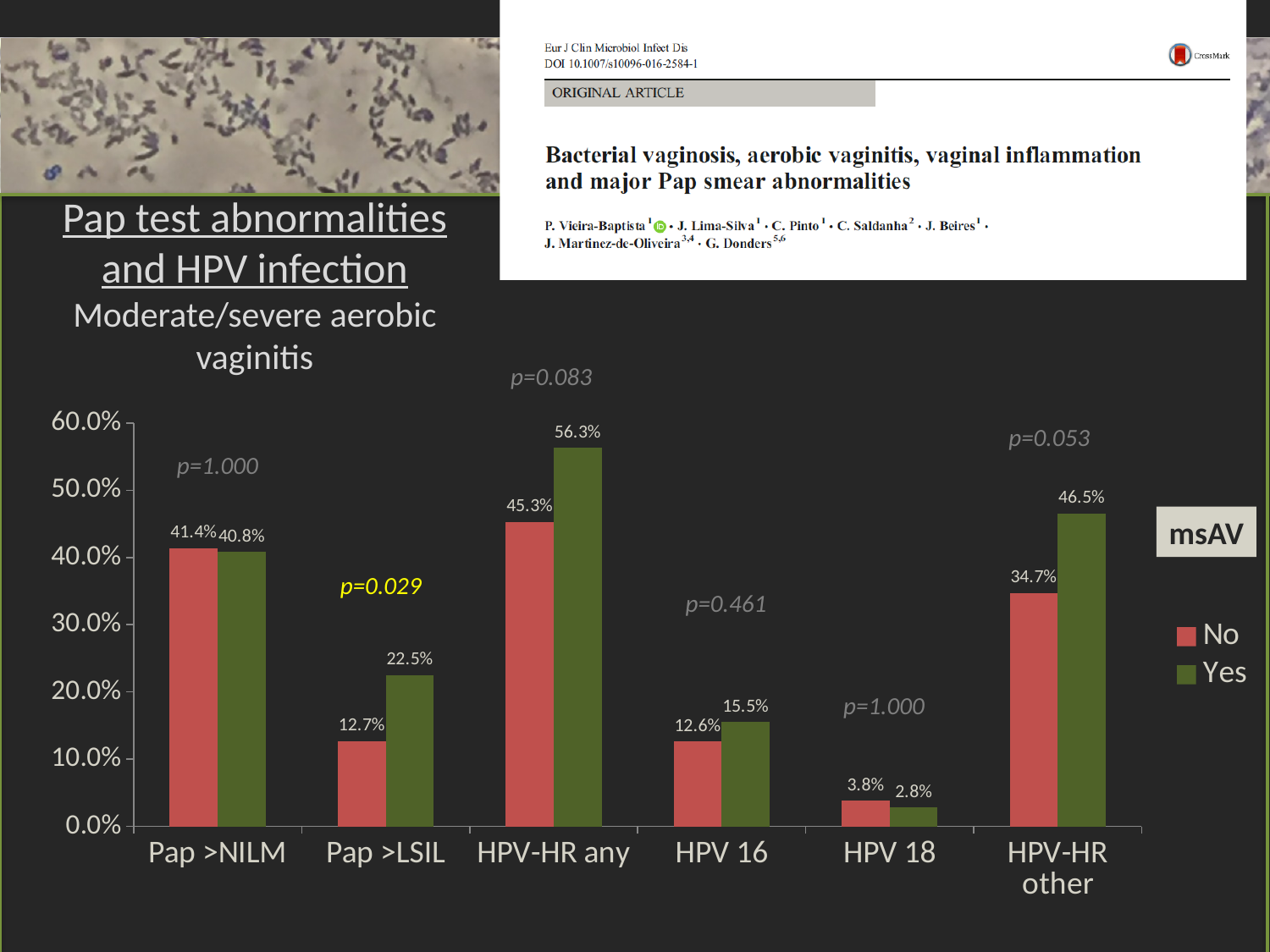
What is the value for the 'Yes' series in the Pap >LSIL category? 22.5% What is the value for the 'Yes' series in the HPV-HR other category? 46.5% What is the value for the 'No' series in the HPV-HR any category? 45.3% What p-value is shown above the Pap >LSIL category? p=0.029 Which category has the lowest value for the 'No' series? HPV 18 How many series does the legend list? 2 Which category has the highest value for the 'Yes' series? HPV-HR any How many categories are shown on the x axis? 6 What is the difference between the 'Yes' and 'No' values in the Pap >LSIL category? 9.8% What kind of chart is shown on the slide? bar chart Is the 'No' value for HPV-HR other greater or less than 30.0%? greater In the HPV 18 category, which series has the larger value, 'No' or 'Yes'? No